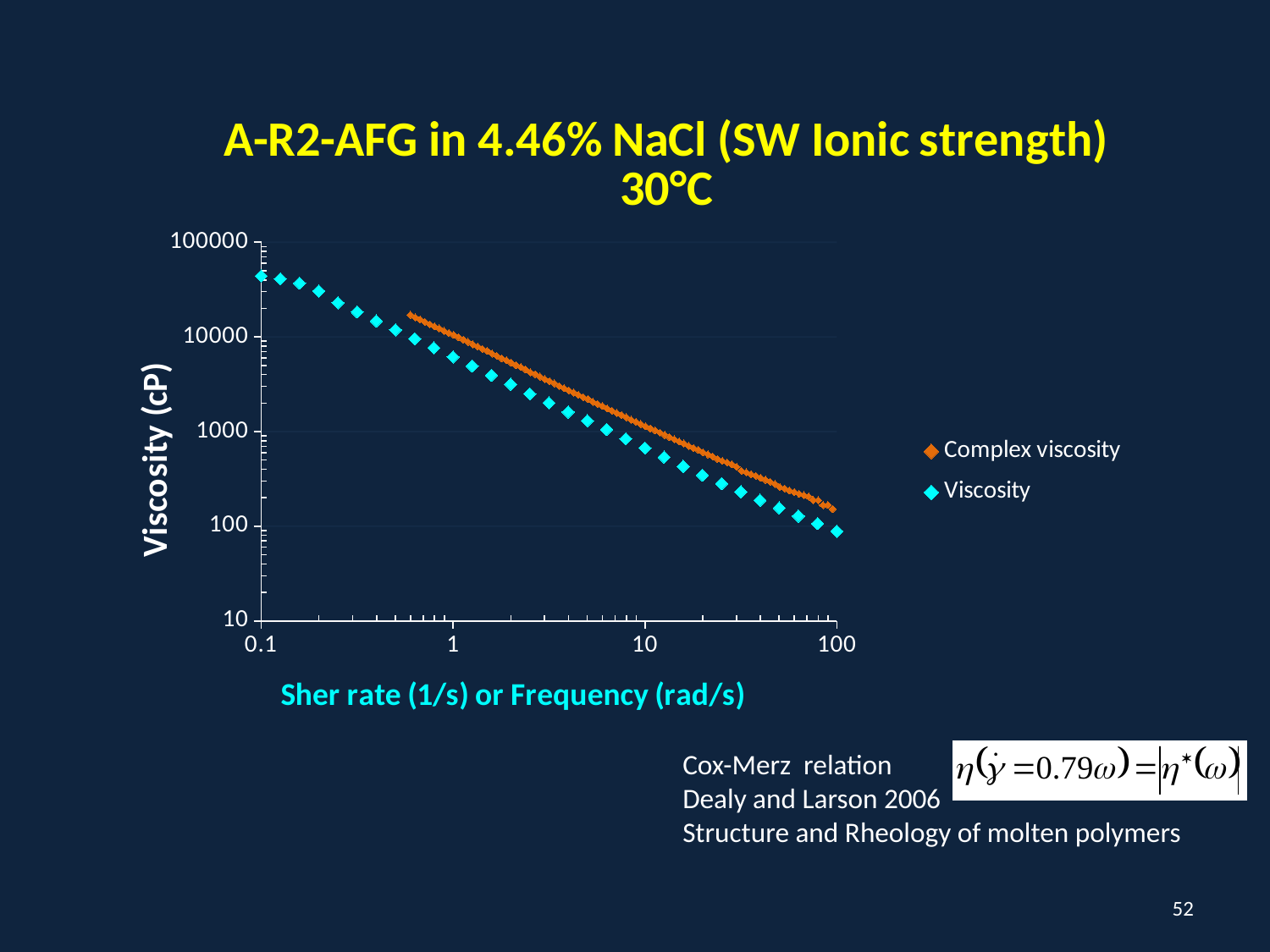
Is the Complex viscosity value at a frequency of 100 rad/s greater or less than 100 cP? greater What is the label of the y axis? Viscosity (cP) What kind of chart is shown on the slide? scatter chart At an x-axis value of 10, which series has the higher value, Complex viscosity or Viscosity? Complex viscosity What is the title of the chart? A-R2-AFG in 4.46% NaCl (SW Ionic strength) 30°C Is the Viscosity value at a shear rate of 100 1/s greater or less than 100 cP? less Do the Viscosity values rise or fall as shear rate increases along the x axis? fall Which series reaches the highest viscosity value on the chart? Viscosity How many series does the legend list? 2 Do the Complex viscosity values rise or fall as frequency increases along the x axis? fall Is the Viscosity value at a shear rate of 10 1/s greater or less than 1000 cP? less